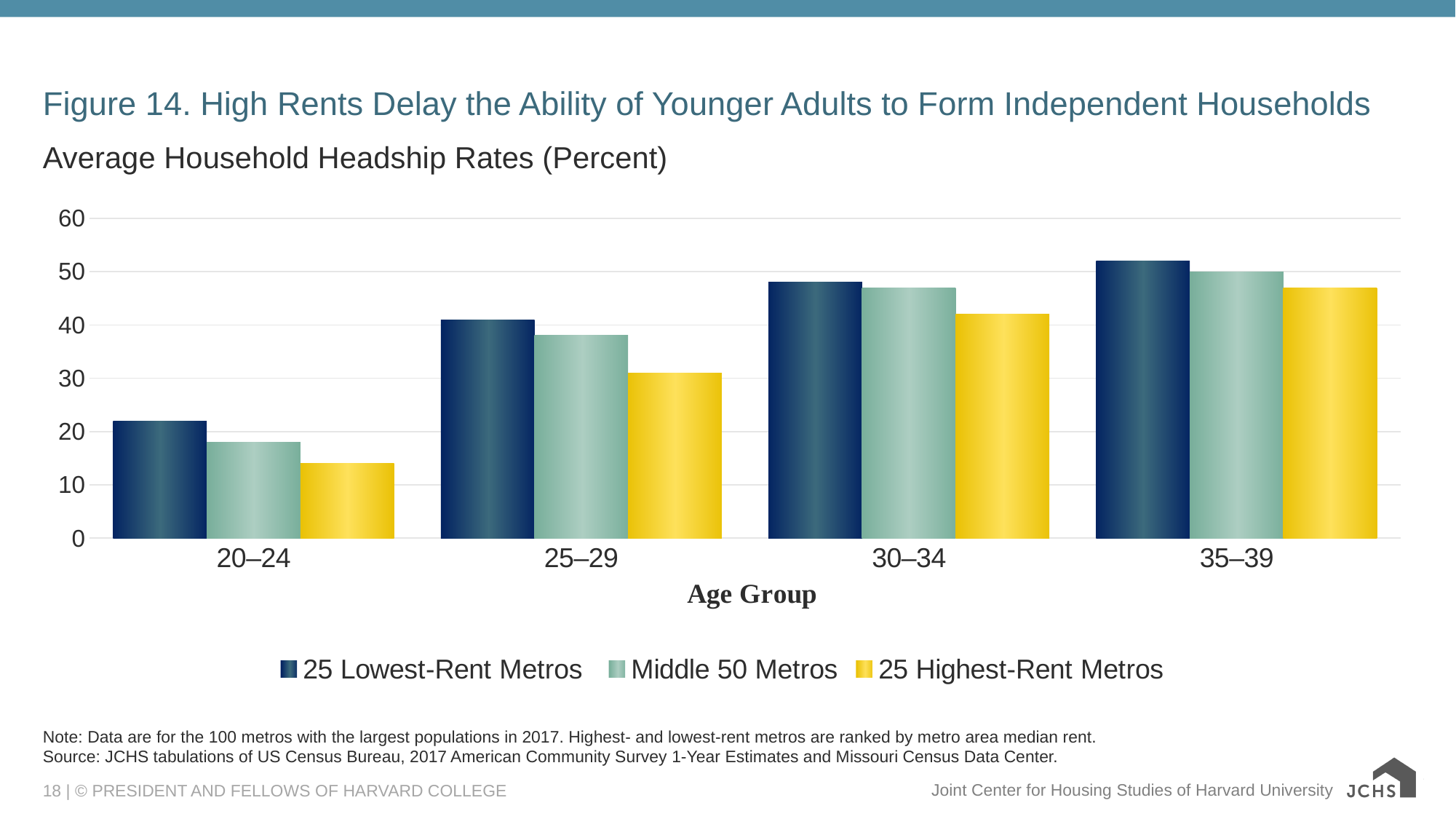
Which age group has the highest headship rate for the 25 Lowest-Rent Metros? 35–39 Which age group has the lowest headship rate for the 25 Highest-Rent Metros? 20–24 How many age groups are shown on the x axis? 4 Do the headship rates for the 25 Highest-Rent Metros rise or fall as age group increases along the x axis? rise What kind of chart is shown on the slide? bar chart Is the value for 25 Highest-Rent Metros in the 20–24 age group greater or less than 20? less How many series does the legend list? 3 Is the value for 25 Lowest-Rent Metros in the 35–39 age group greater or less than 50? greater Is the value for Middle 50 Metros in the 25–29 age group greater or less than 40? less What is the label of the x axis? Age Group Which series is shown in yellow? 25 Highest-Rent Metros In the 30–34 age group, which is larger: the value for 25 Lowest-Rent Metros or the value for 25 Highest-Rent Metros? 25 Lowest-Rent Metros